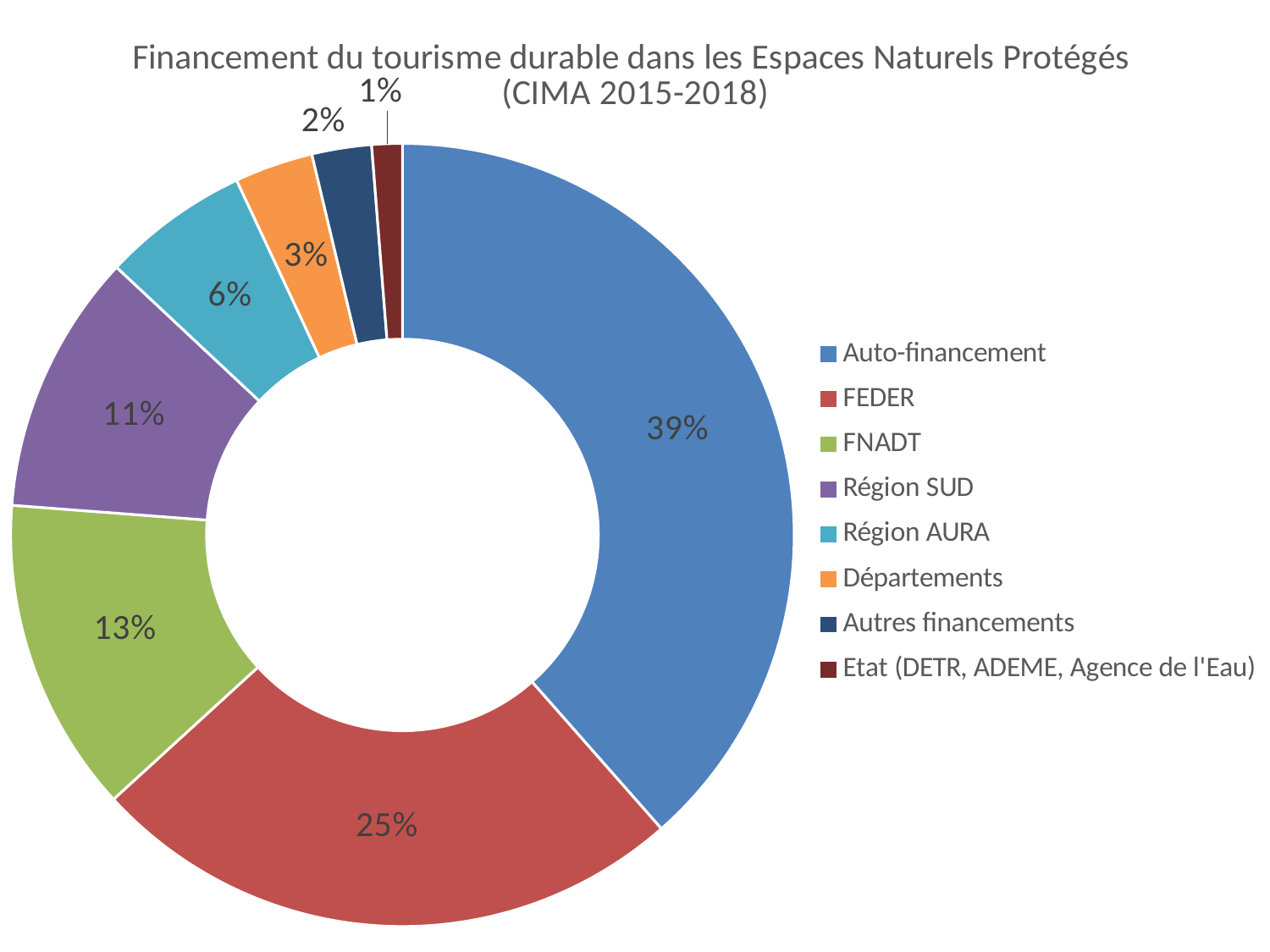
What share of the funding comes from Auto-financement? 39% Which funding source has the largest share? Auto-financement What percentage is shown for FEDER? 25% What percentage does Région AURA represent? 6% How many funding sources are listed in the legend? 8 Which funding source has the smallest share? Etat (DETR, ADEME, Agence de l'Eau) What is the difference in percentage points between Auto-financement and FEDER? 14 Which is larger, the share for FNADT or the share for Région SUD? FNADT What is the value for FNADT? 13% What share is attributed to Région SUD? 11% What is the value for Départements? 3% What type of chart is shown on the slide? Pie chart (doughnut)